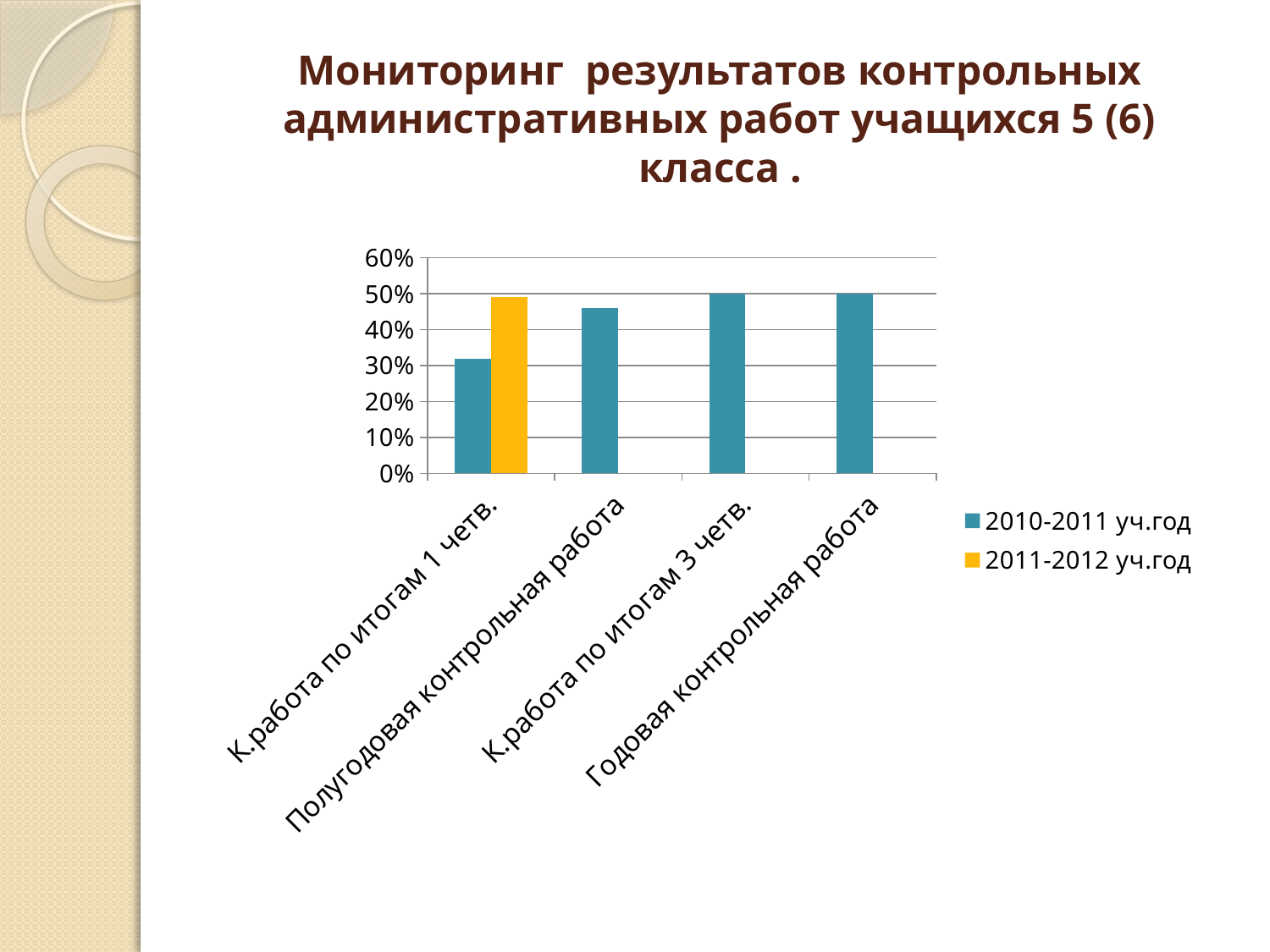
Is the value for 2010-2011 уч.год for К.работа по итогам 1 четв. greater or less than 40%? less What is the value for 2010-2011 уч.год for К.работа по итогам 3 четв.? 50% What kind of chart is shown on the slide? bar chart What colour are the bars for the 2011-2012 уч.год series? yellow Which category is the only one with a bar for the 2011-2012 уч.год series? К.работа по итогам 1 четв. For К.работа по итогам 1 четв., which series has the larger value: 2010-2011 уч.год or 2011-2012 уч.год? 2011-2012 уч.год How many categories are shown on the x axis of the chart? 4 What is the value for 2010-2011 уч.год for Годовая контрольная работа? 50% Is the value for 2011-2012 уч.год for К.работа по итогам 1 четв. greater or less than 40%? greater How many series does the chart legend list? 2 Which category has the lowest value for the 2010-2011 уч.год series? К.работа по итогам 1 четв. Is the value for 2010-2011 уч.год for Полугодовая контрольная работа greater or less than 40%? greater